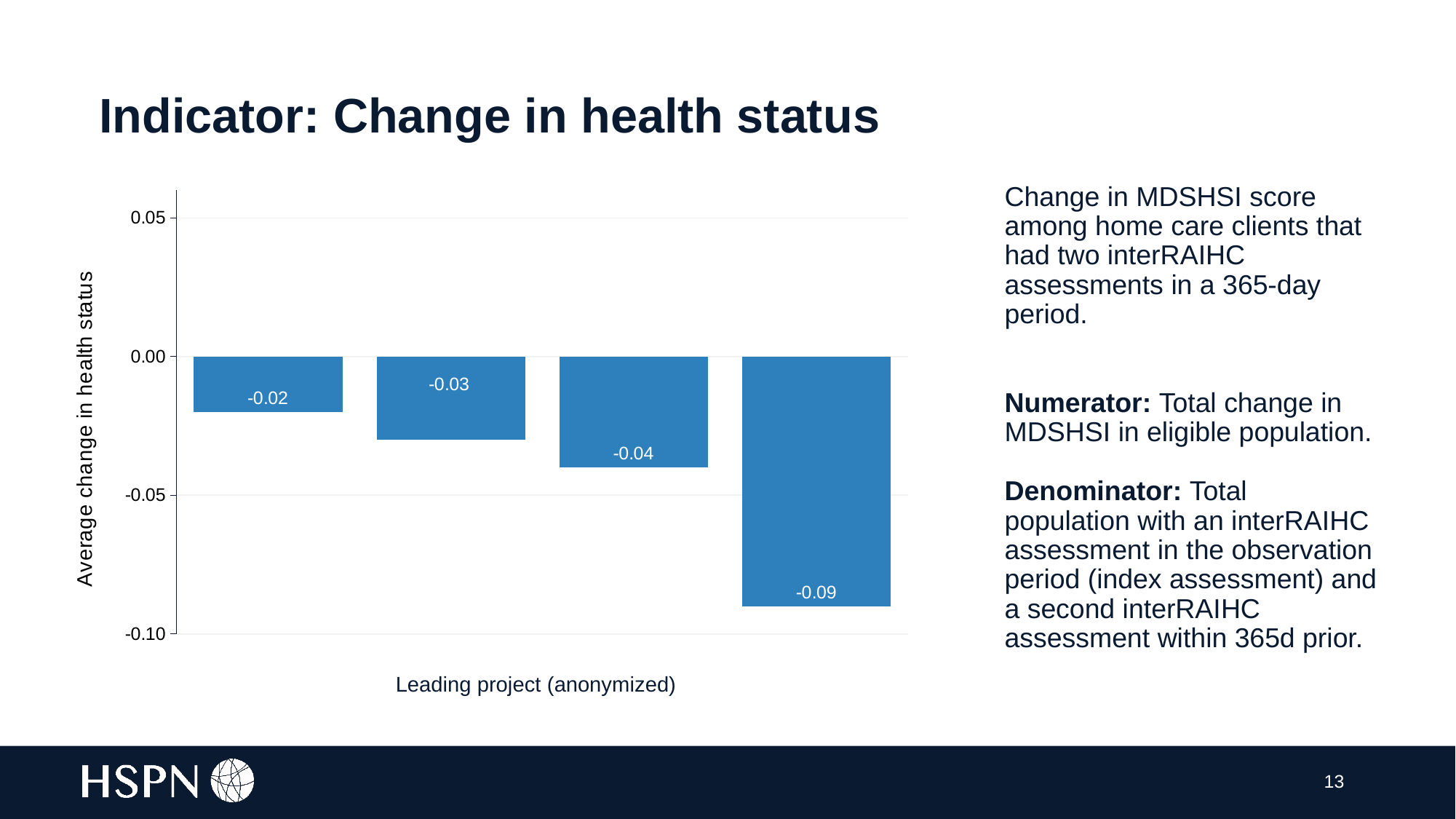
What is the title of the x axis? Leading project (anonymized) What is the title of the y axis? Average change in health status How many bars are plotted in the chart? 4 What is the value of the second bar from the left? -0.03 What is the value of the rightmost bar in the chart? -0.09 What is the value of the third bar from the left? -0.04 Do the bar values rise or fall from left to right along the x axis? fall What is the value of the leftmost bar in the chart? -0.02 Which bar has the highest value? the leftmost (first) bar What is the difference between the values of the leftmost bar and the rightmost bar? 0.07 What kind of chart is shown on the slide? bar chart Which bar has the lowest value? the rightmost (fourth) bar